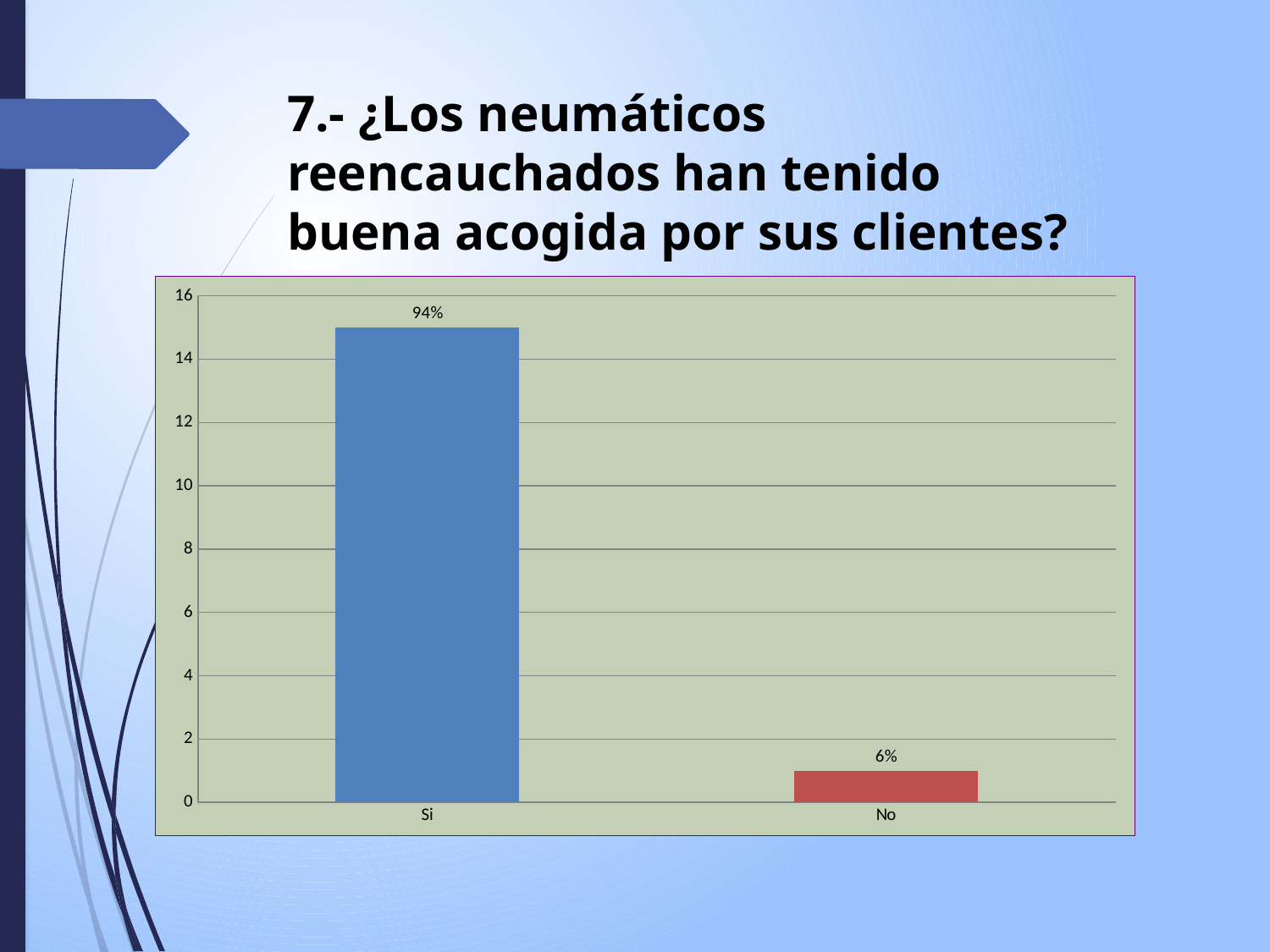
Which category has the highest bar? Si Is the bar for No greater or less than 2 on the vertical axis? less Which category has the lowest bar? No What colour is the bar for Si? Blue How many categories are shown on the x axis? 2 Which is larger, the value for Si or the value for No? Si Is the bar for Si greater or less than 10 on the vertical axis? greater What kind of chart is shown on the slide? Bar chart What is the difference between the data labels for Si and No? 88% What is the highest value shown on the vertical axis? 16 What data label is shown on the bar for No? 6% What data label is shown on the bar for Si? 94%